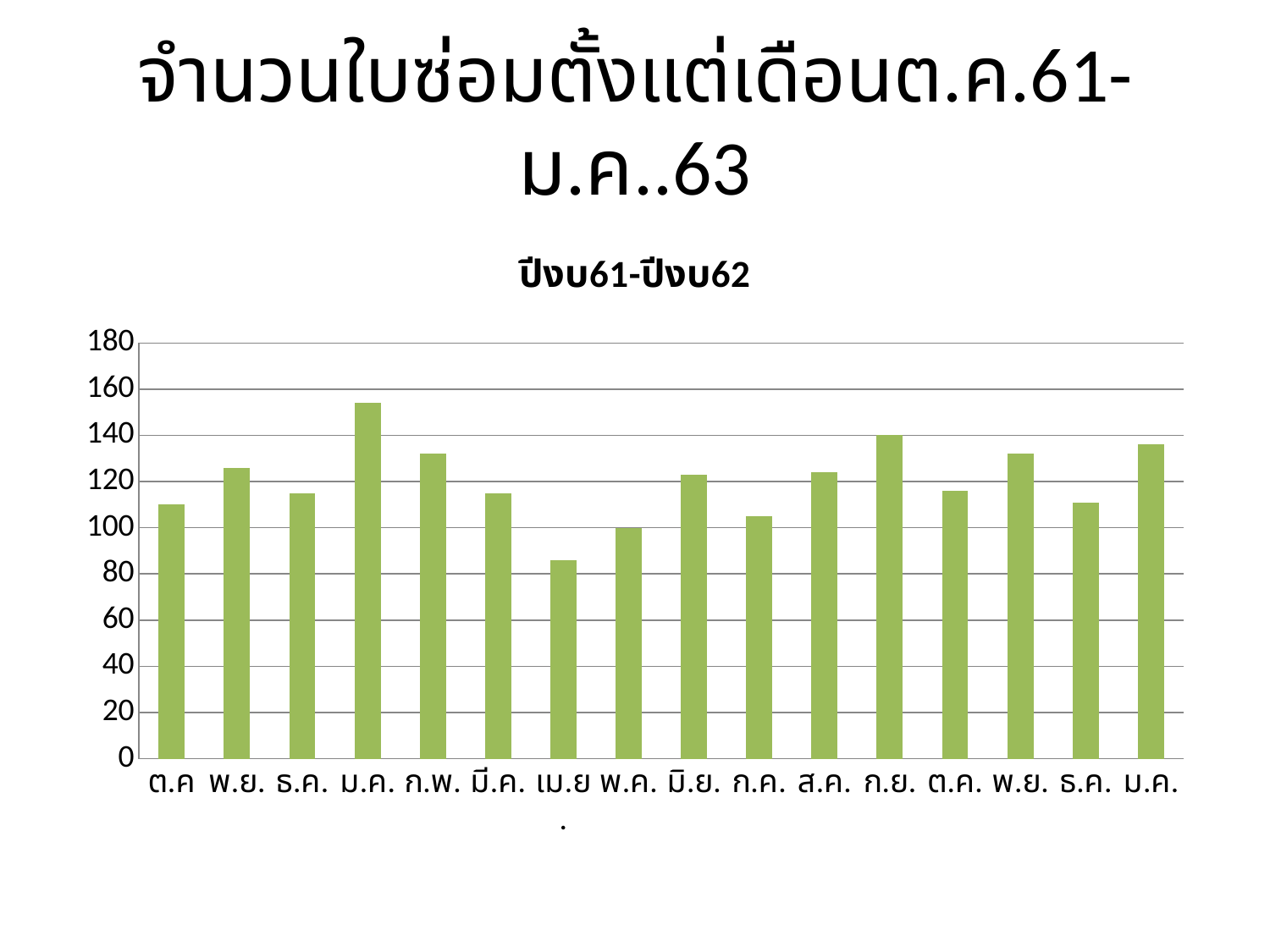
What is the title shown directly above the chart area? ปีงบ61-ปีงบ62 Is the value for เม.ย. greater or less than 100? less Is the value for the first ม.ค. bar greater or less than 140? greater Is the value for the first ต.ค bar greater or less than 100? greater Which is larger, the value for ก.ย. or the value for ก.ค.? ก.ย. What kind of chart is shown on the slide? bar chart Which month has the highest bar in the chart? ม.ค. (the first one) Which month has the lowest bar in the chart? เม.ย. Which is larger, the value for เม.ย. or the value for มิ.ย.? มิ.ย. How many bars (months) are plotted in the chart? 16